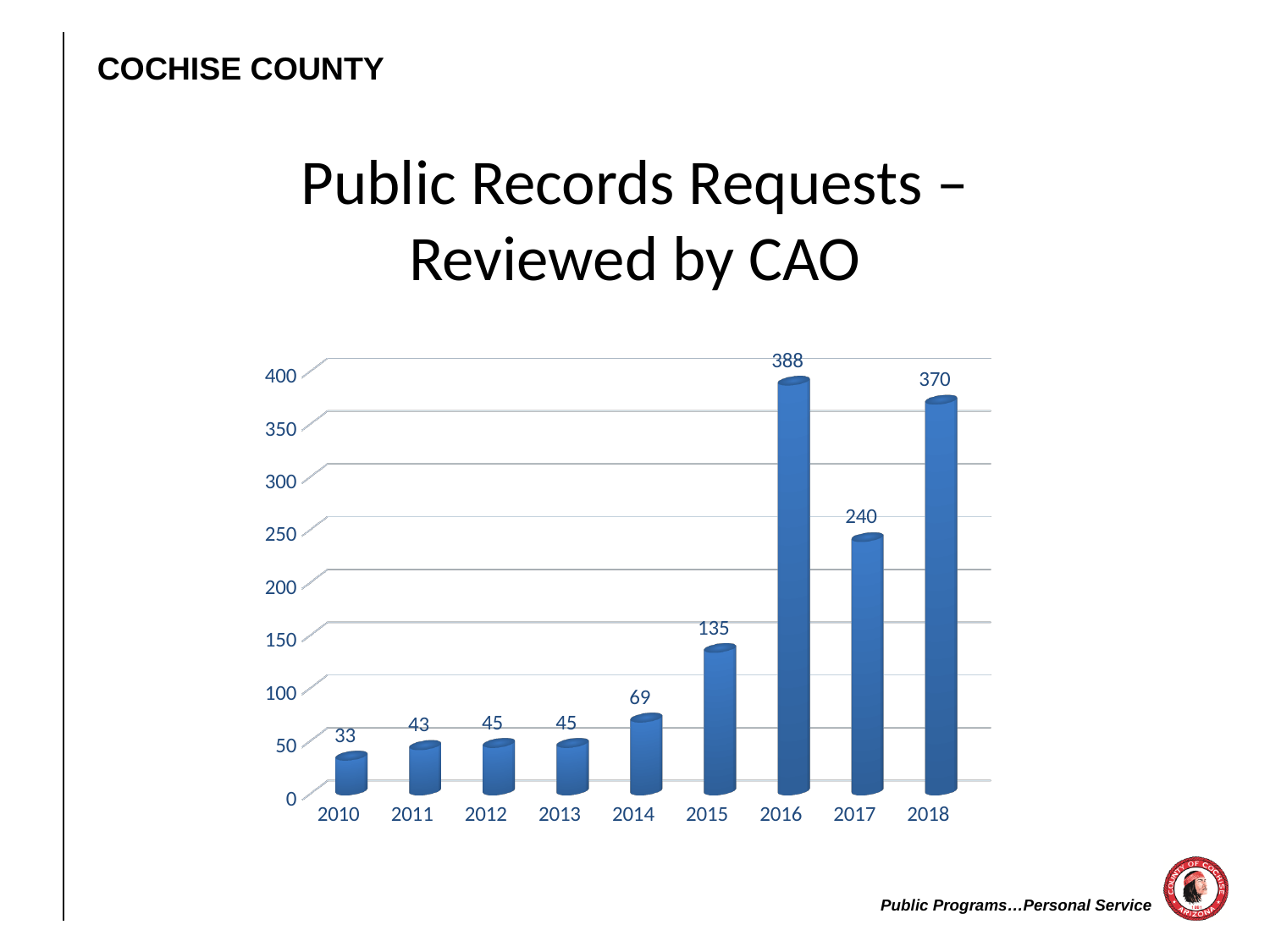
What is the difference between the values for 2016 and 2017? 148 Which year has the lowest value? 2010 Which year has the highest value? 2016 Is the value for 2017 greater or less than 200? greater What is the title of the chart? Public Records Requests – Reviewed by CAO What is the difference between the values for 2018 and 2015? 235 What is the value for 2015? 135 What is the value for 2016? 388 What kind of chart is shown on the slide? bar chart How many years are shown on the x axis? 9 What is the value for 2010? 33 Which is larger, the value for 2017 or the value for 2018? 2018